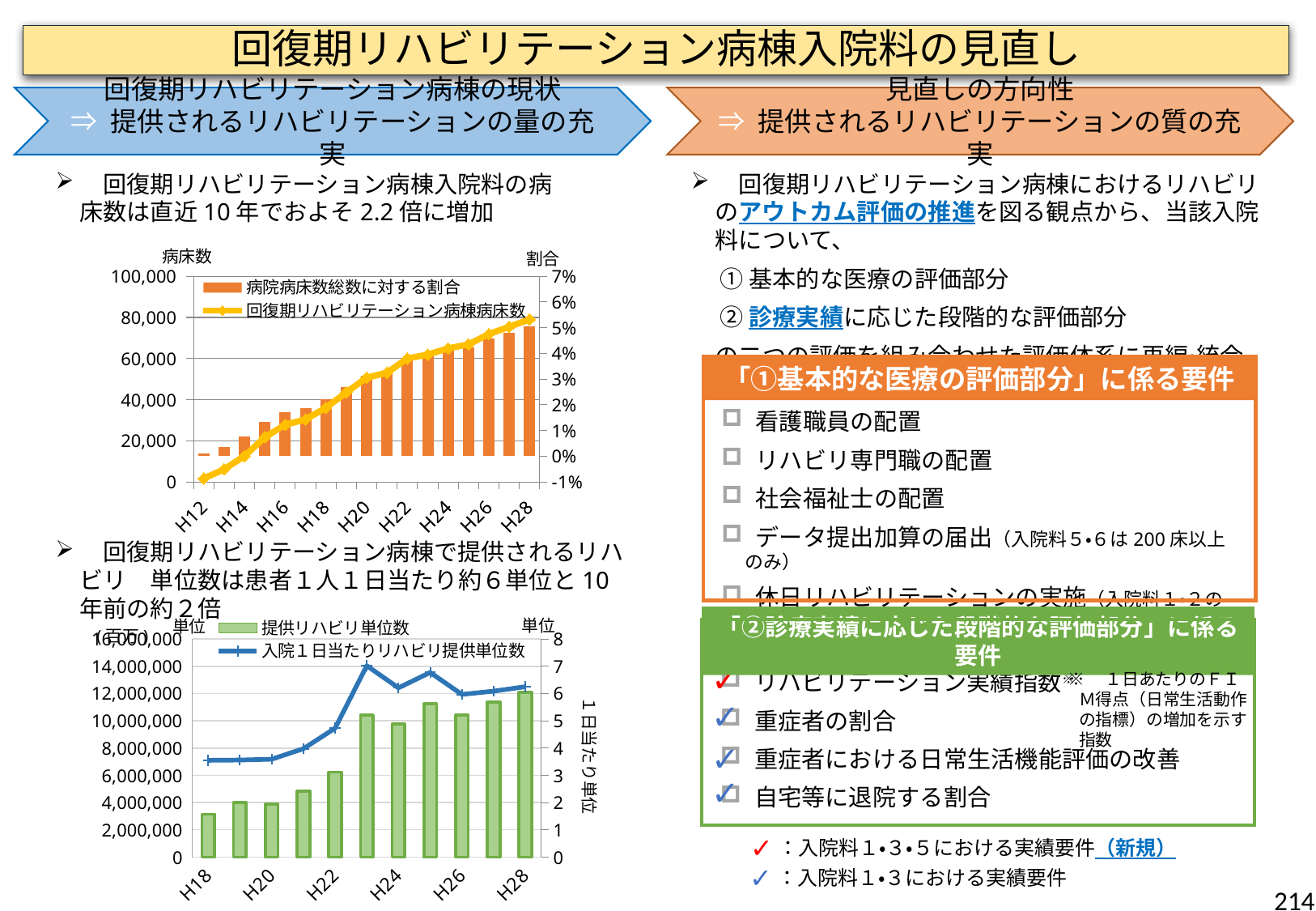
How many years (bars) are plotted in the lower-left chart (提供リハビリ単位数)? 11 In the lower-left chart, which is larger, the 提供リハビリ単位数 value for H18 or for H28? H28 In the lower-left chart, is the 提供リハビリ単位数 value for H18 greater or less than 4,000,000? less In the upper-left chart (病床数), is the 回復期リハビリテーション病棟病床数 value at H28 greater or less than 60,000? greater In the upper-left chart (病床数), does the 回復期リハビリテーション病棟病床数 line rise or fall from H12 to H28? Rises How many series does the legend of the lower-left chart (提供リハビリ単位数) list? 2 How many series does the legend of the upper-left chart (病床数) list? 2 In the upper-left chart (病床数), which year has the highest 回復期リハビリテーション病棟病床数 value? H28 In the lower-left chart, is the 提供リハビリ単位数 value for H28 greater or less than 10,000,000? greater What kind of chart is the upper chart on the left side of the slide (病床数)? A combined bar and line chart In the lower-left chart, which year has the highest 入院１日当たりリハビリ提供単位数 value? H23